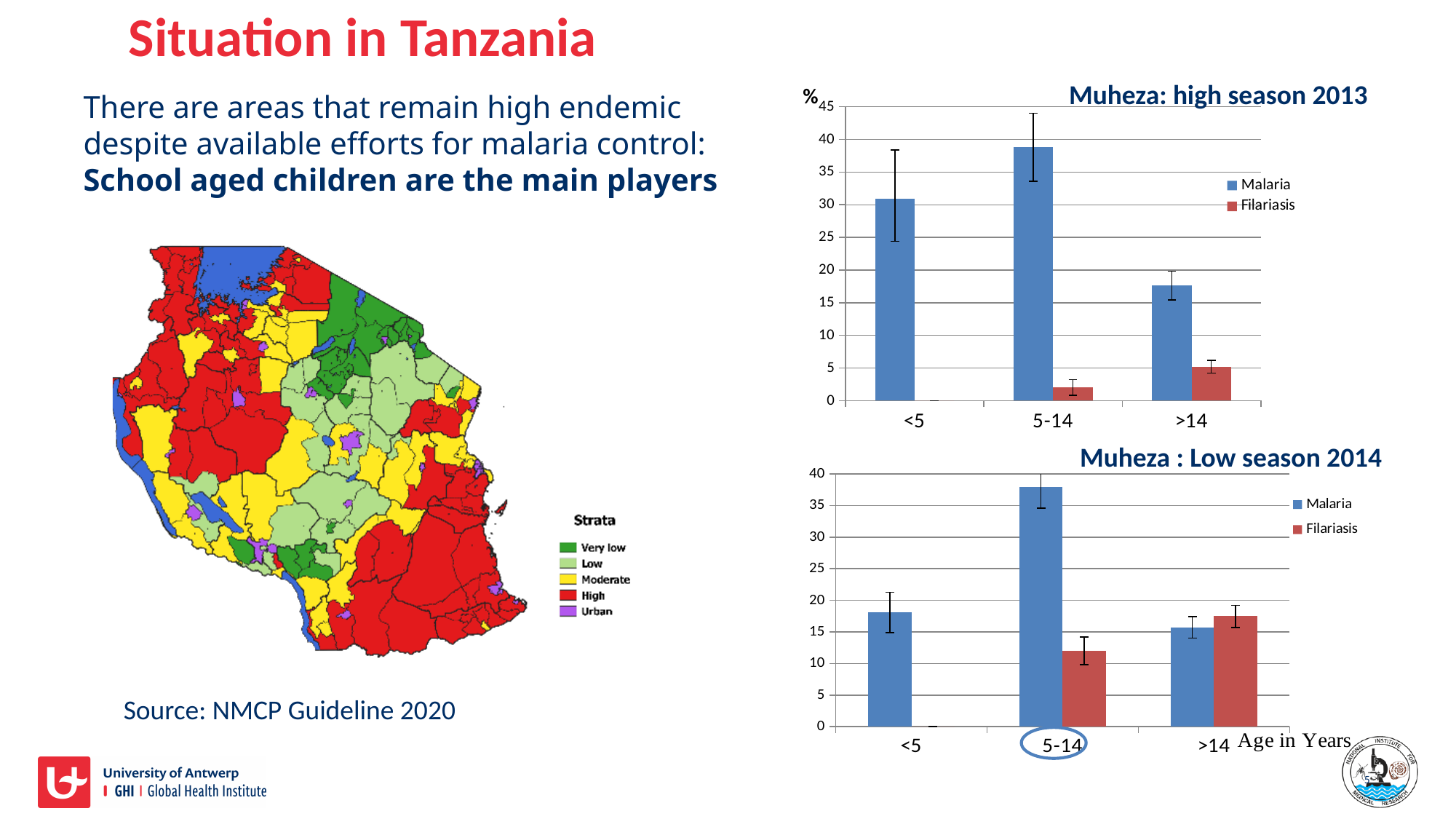
In the 'Muheza: high season 2013' chart, is the Malaria value for 5-14 greater or less than 35? greater In the 'Muheza : Low season 2014' chart, which age group has the highest Malaria value? 5-14 In the 'Muheza: high season 2013' chart, what kind of chart is shown? bar chart In the 'Muheza : Low season 2014' chart, is the Malaria value for <5 greater or less than 25? less In the 'Muheza : Low season 2014' chart, which age group has the highest Filariasis value? >14 In the 'Muheza: high season 2013' chart, is the Filariasis value for >14 greater or less than 10? less In the 'Muheza : Low season 2014' chart, which is larger for the 5-14 age group, Malaria or Filariasis? Malaria In the 'Muheza: high season 2013' chart, how many series does the legend list? 2 In the 'Muheza: high season 2013' chart, which age group has the highest Malaria value? 5-14 In the 'Muheza: high season 2013' chart, how many age categories are shown on the x axis? 3 In the 'Muheza: high season 2013' chart, which age group has the lowest Malaria value? >14 In the 'Muheza : Low season 2014' chart, which series is shown in red? Filariasis